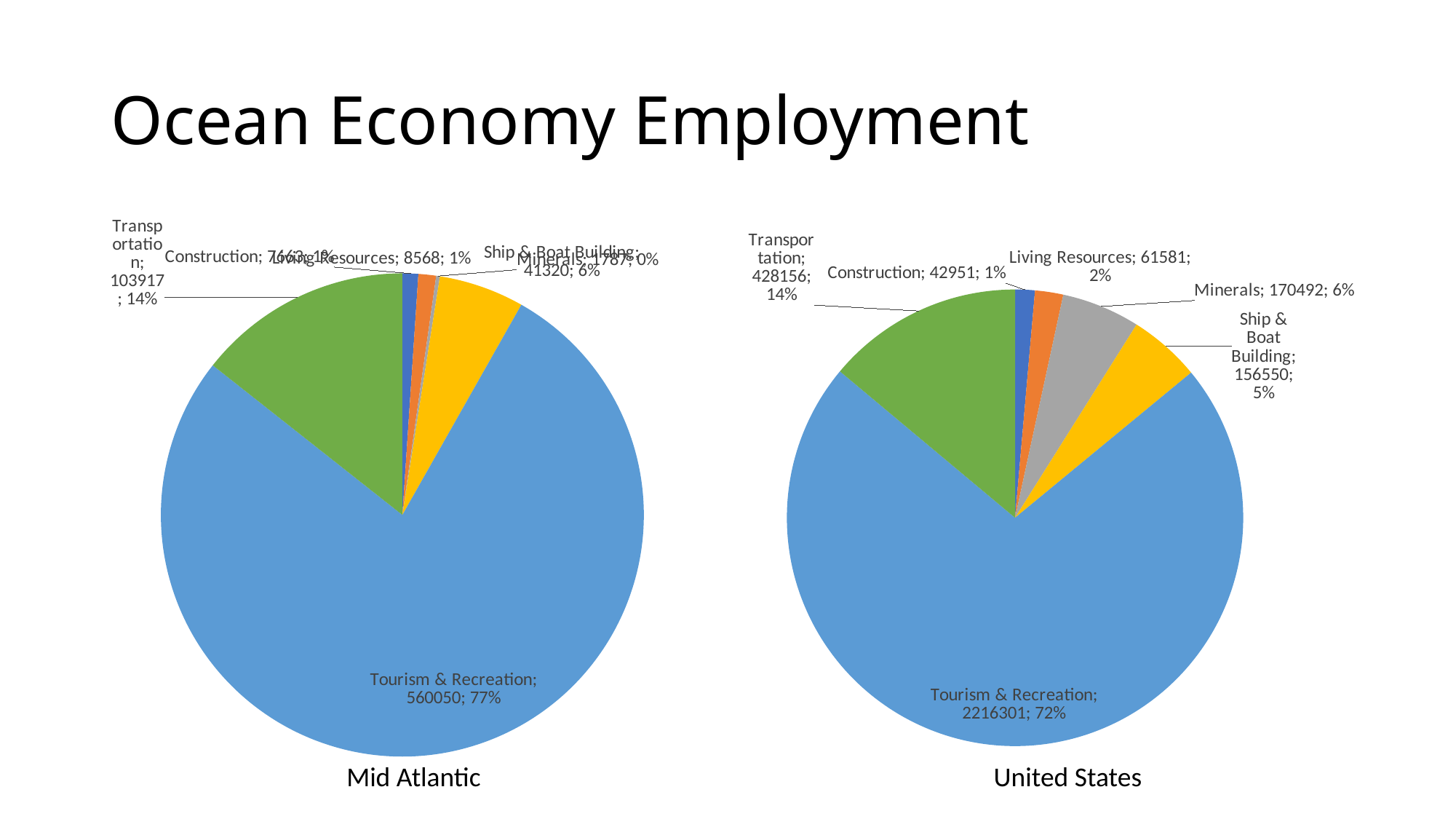
In the Mid Atlantic chart, what is the value for Transportation? 103917 In the Mid Atlantic chart, what share of the pie does Tourism & Recreation hold? 77% In the United States chart, what is the value for Minerals? 170492 In the United States chart, what share of the pie does Transportation hold? 14% In the United States chart, which sector has the largest slice? Tourism & Recreation In the United States chart, what is the value for Tourism & Recreation? 2216301 In the Mid Atlantic chart, what is the value for Ship & Boat Building? 41320 In the Mid Atlantic chart, what is the employment value for Tourism & Recreation? 560050 In the United States chart, what is the difference between the Minerals and Ship & Boat Building values? 13942 In the United States chart, what is the value for Living Resources? 61581 What kind of charts are shown on the slide? Pie charts In the United States chart, which is larger: Minerals or Ship & Boat Building? Minerals